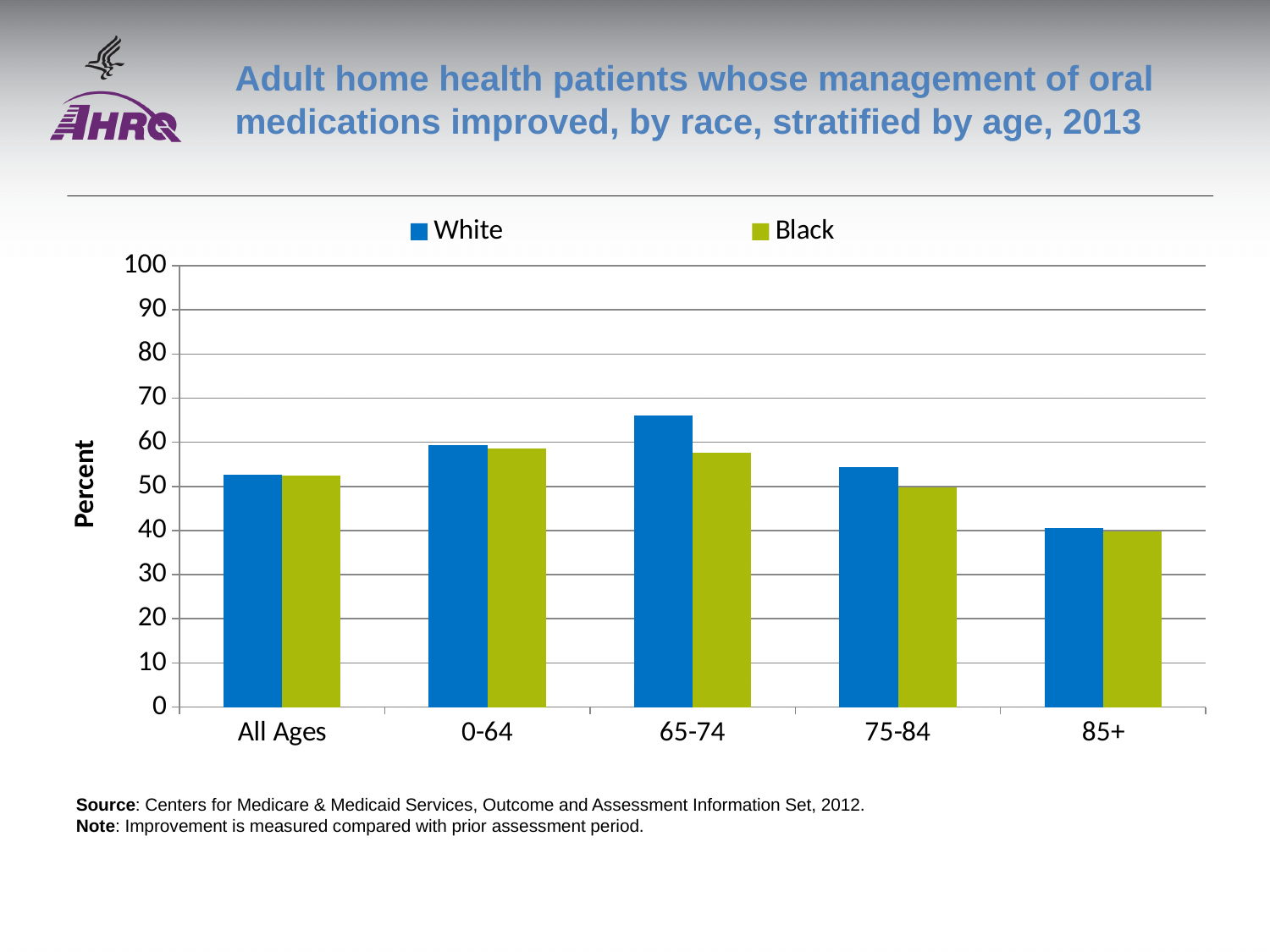
Is the value for White in the 65-74 age group greater or less than 60? greater Which age category has the lowest value for White? 85+ Which age category has the highest value for White? 65-74 Is the value for Black in the 85+ age group greater or less than 50? less How many age categories are shown on the x axis? 5 Which age category has the lowest value for Black? 85+ Do the White values rise or fall from the 65-74 age group to the 85+ age group? fall For the 65-74 age group, which is larger, the White value or the Black value? White What kind of chart is shown on the slide? Bar chart What is the label on the y axis? Percent How many series does the legend list? 2 For the 75-84 age group, which is larger, the White value or the Black value? White